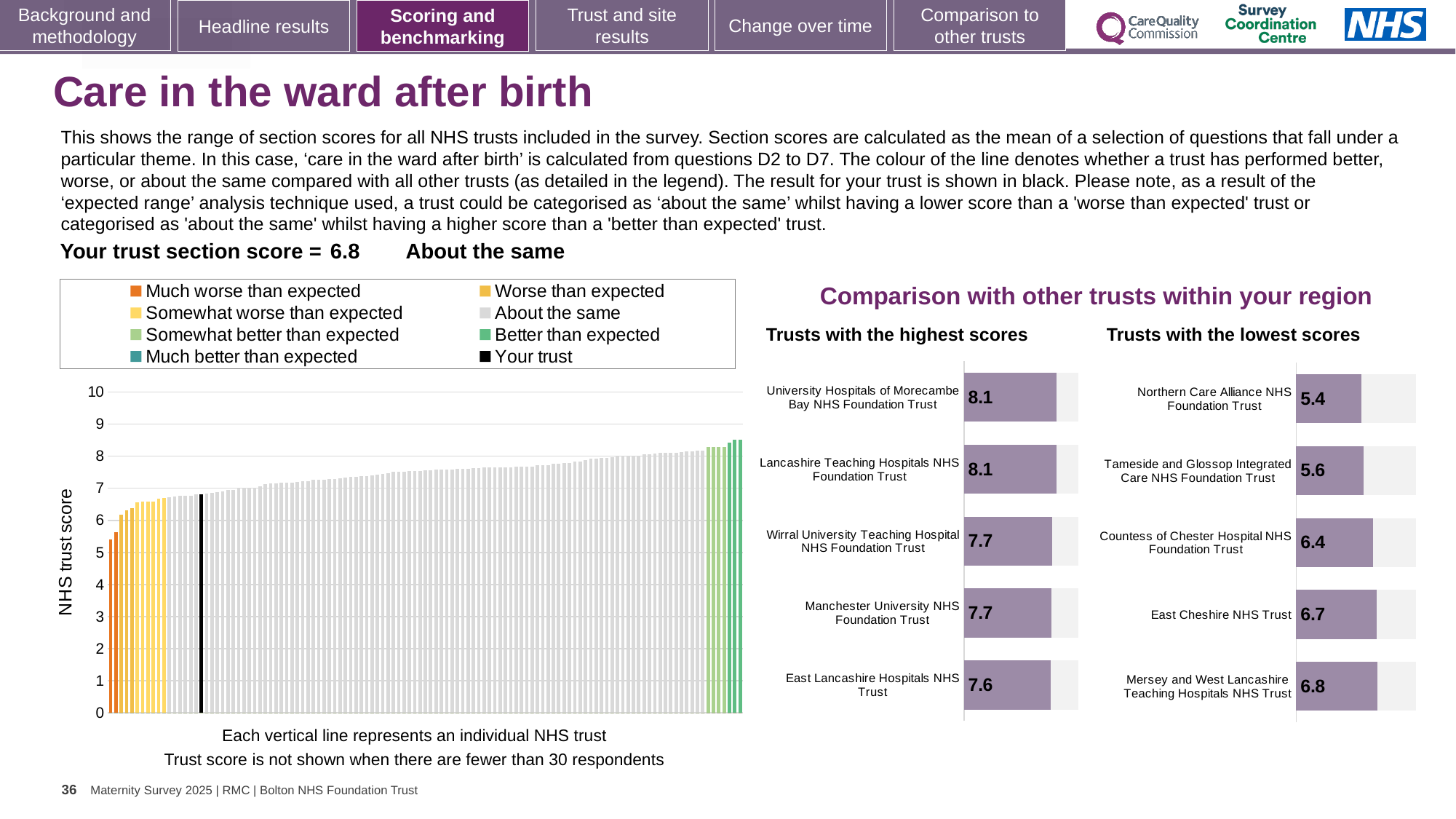
How many trusts are shown in the 'Trusts with the highest scores' chart? 5 How many entries does the legend of the 'NHS trust score' chart list? 8 In the 'Trusts with the highest scores' chart, what is the score for East Lancashire Hospitals NHS Trust? 7.6 In the 'Trusts with the lowest scores' chart, which has the larger score: Countess of Chester Hospital NHS Foundation Trust or East Cheshire NHS Trust? East Cheshire NHS Trust In the 'Trusts with the lowest scores' chart, what is the score for Countess of Chester Hospital NHS Foundation Trust? 6.4 In the 'Trusts with the lowest scores' chart, which trust has the lowest score? Northern Care Alliance NHS Foundation Trust In the 'NHS trust score' chart, is the value of the tallest bar greater or less than 8? greater In the 'NHS trust score' chart, do the values rise or fall from left to right? Rise In the 'Trusts with the lowest scores' chart, which trust has the highest score? Mersey and West Lancashire Teaching Hospitals NHS Trust What kind of chart is the 'NHS trust score' chart on the left? Bar chart In the 'Trusts with the lowest scores' chart, what is the difference between the score for Mersey and West Lancashire Teaching Hospitals NHS Trust and the score for Northern Care Alliance NHS Foundation Trust? 1.4 In the 'Trusts with the highest scores' chart, what is the difference between the score for University Hospitals of Morecambe Bay NHS Foundation Trust and the score for East Lancashire Hospitals NHS Trust? 0.5